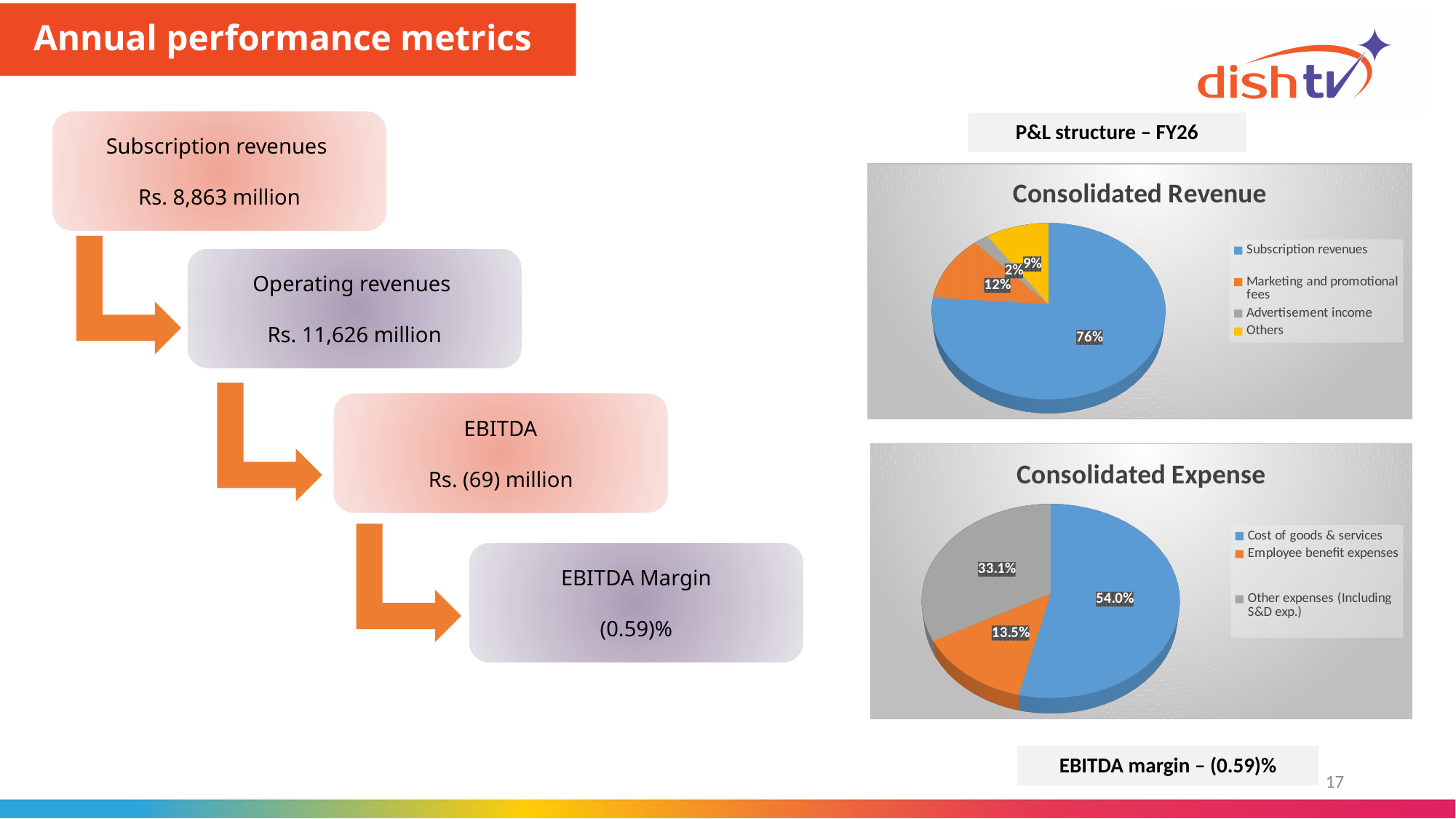
In the Consolidated Revenue chart, what share of revenue comes from Subscription revenues? 76% In the Consolidated Expense chart, which category has the smallest share? Employee benefit expenses In the Consolidated Revenue chart, which category has the largest share? Subscription revenues In the Consolidated Revenue chart, what share of revenue comes from Marketing and promotional fees? 12% What kind of chart is the Consolidated Expense chart? Pie chart In the Consolidated Expense chart, what share of expenses is Cost of goods & services? 54.0% In the Consolidated Expense chart, what is the difference between the Cost of goods & services share and the Other expenses (Including S&D exp.) share? 20.9% In the Consolidated Revenue chart, how many categories does the legend list? 4 In the Consolidated Revenue chart, which category has the smallest share? Advertisement income In the Consolidated Revenue chart, what colour represents Others? Yellow